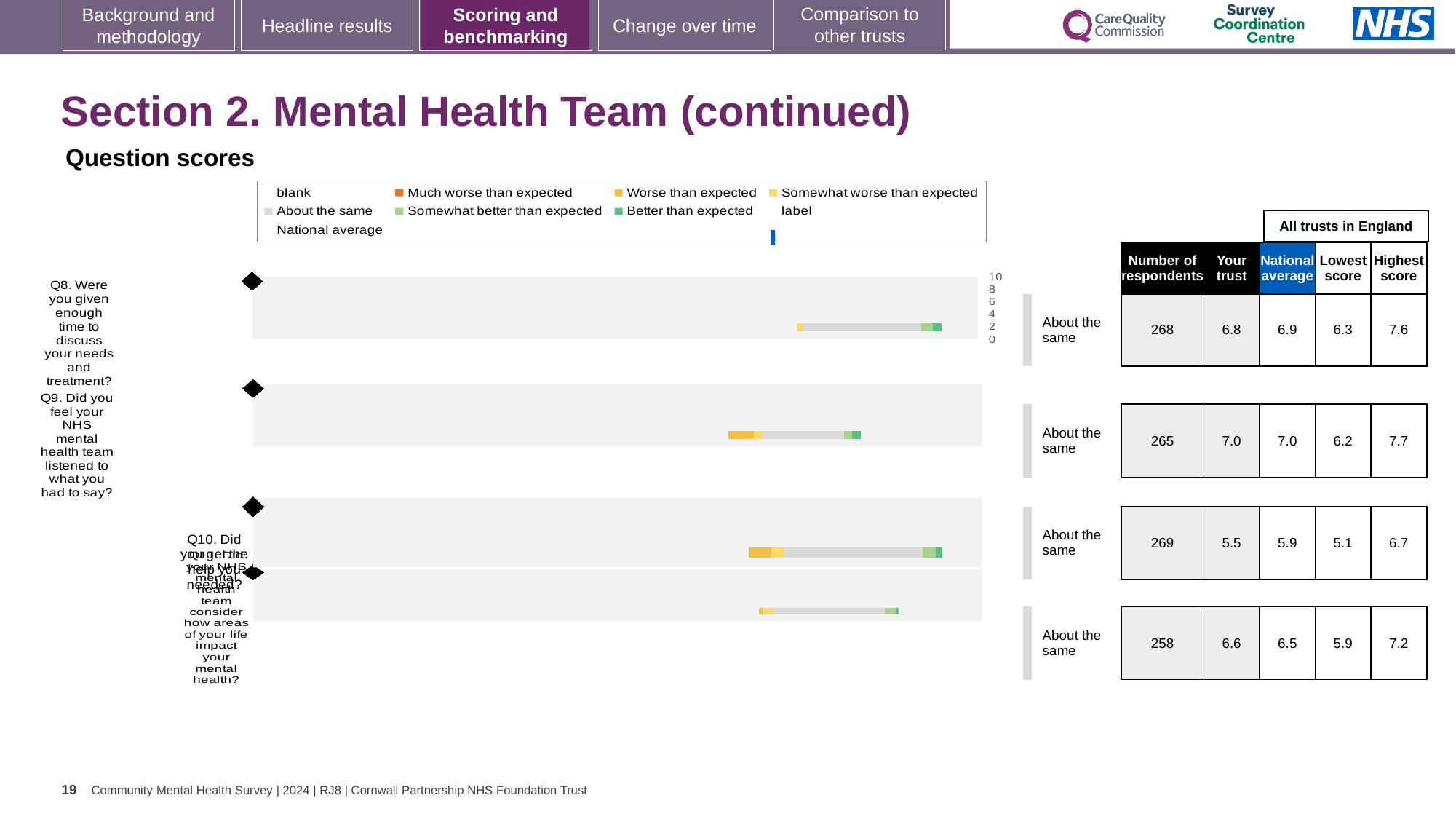
What is the difference between the highest score and the lowest score for Q9? 1.5 For Q8, which is larger: the 'Your trust' score or the national average? National average Which question has the lowest 'Your trust' score? Q10 What kind of chart is used to show the question scores? Bar chart How many respondents answered Q10 (Did you get the help you needed?)? 269 What is the highest score among all trusts in England for Q8? 7.6 How many questions are shown on the slide? 4 Which question has the highest number of respondents? Q10 What is the 'Your trust' score for Q8 (Were you given enough time to discuss your needs and treatment?)? 6.8 What is the lowest score among all trusts in England for Q10? 5.1 What benchmark category is shown for Q8? About the same What is the national average score for Q9 (Did you feel your NHS mental health team listened to what you had to say?)? 7.0